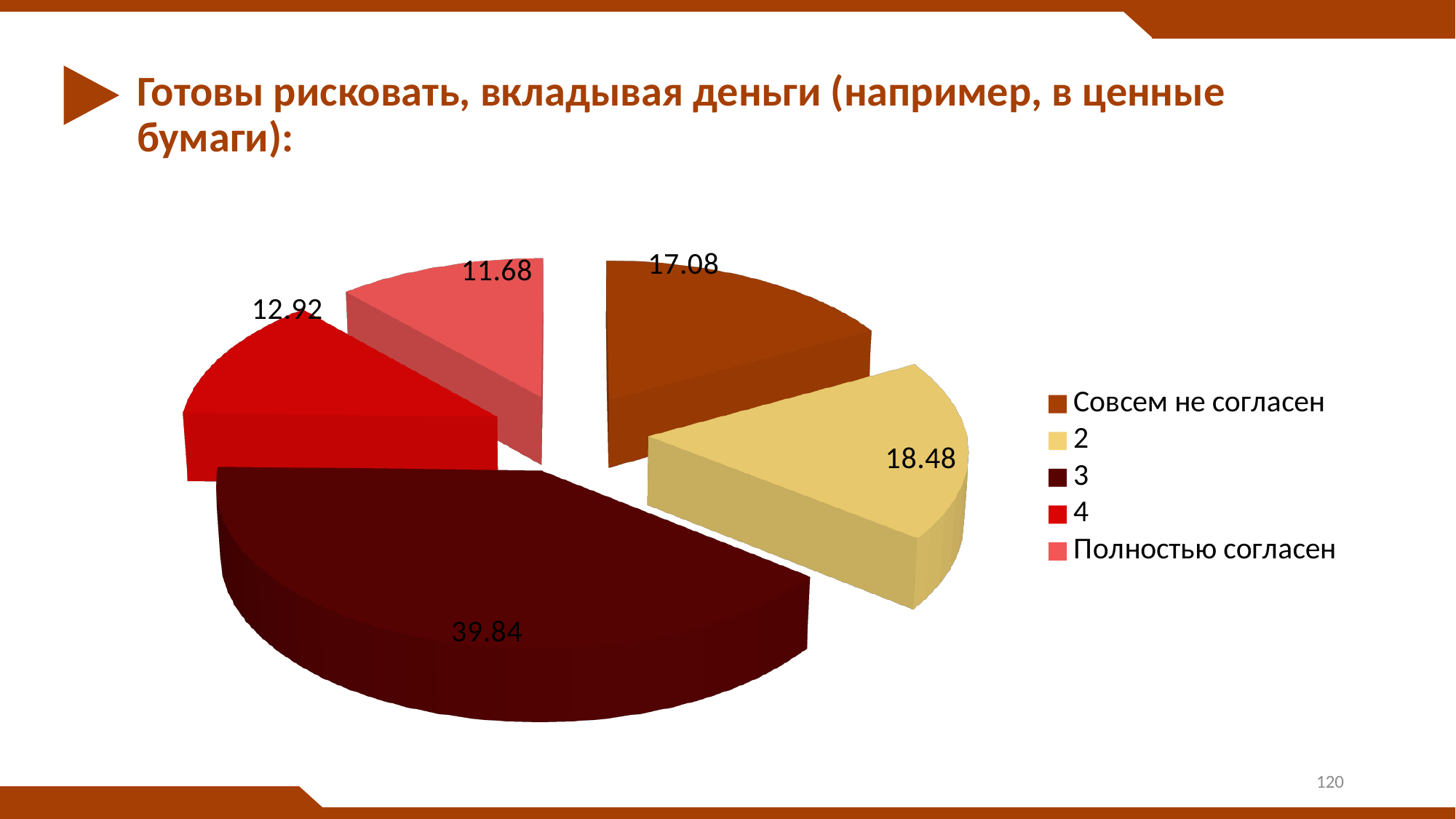
Which is larger, the value for "4" or the value for "Полностью согласен"? 4 What type of chart is shown on the slide? pie chart What is the value for the slice labelled "4"? 12.92 What is the difference between the values for "Совсем не согласен" and "Полностью согласен"? 5.4 What is the value for the slice "Полностью согласен"? 11.68 What is the value for the slice labelled "3"? 39.84 Which category has the smallest slice of the pie? Полностью согласен Which category has the largest slice of the pie? 3 How many categories does the legend list? 5 What is the value for the slice "Совсем не согласен"? 17.08 What is the difference between the values for "3" and "2"? 21.36 What is the value for the slice labelled "2"? 18.48